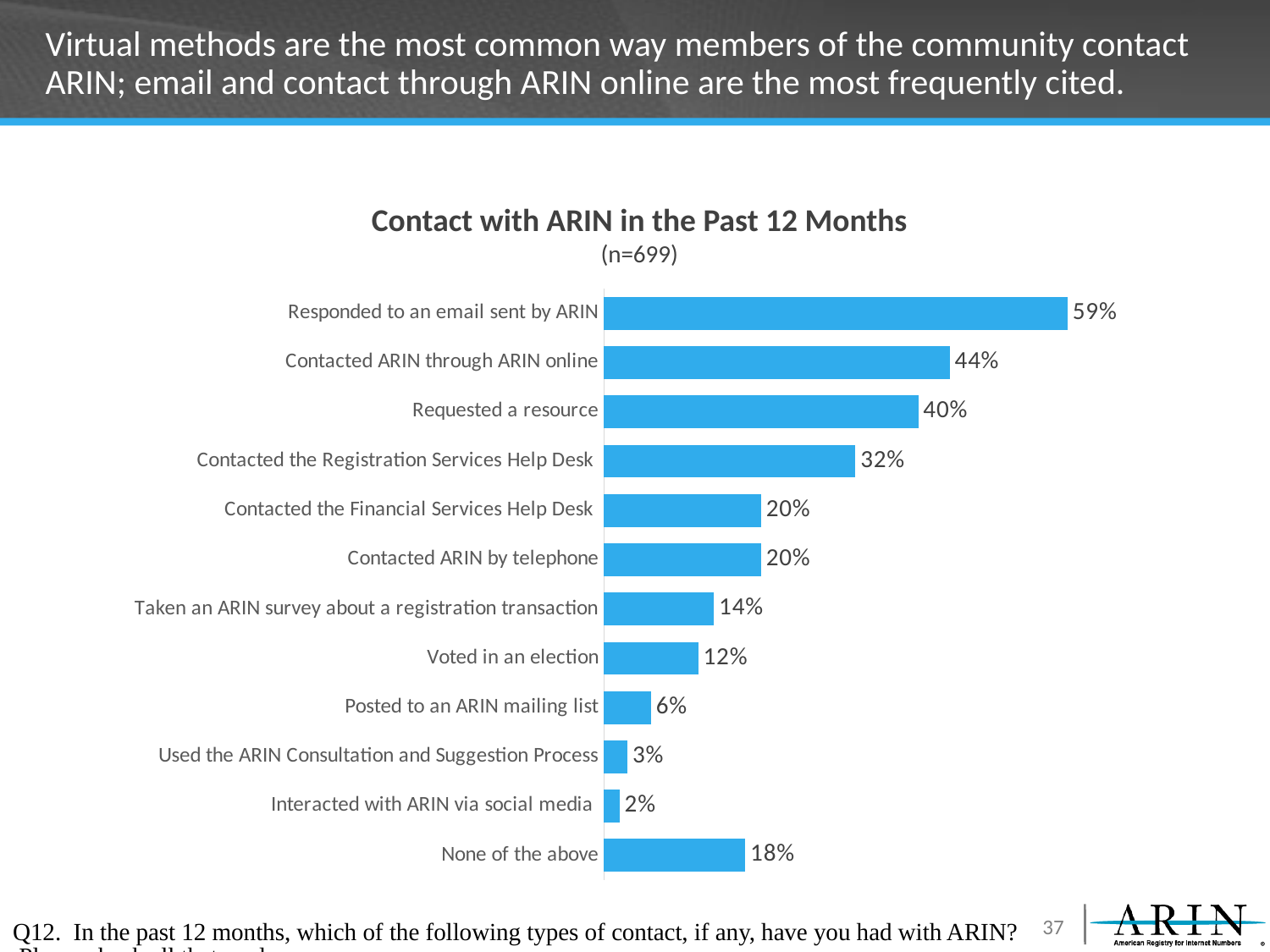
Which is larger: "Posted to an ARIN mailing list" or "Used the ARIN Consultation and Suggestion Process"? Posted to an ARIN mailing list Which category has the lowest value? Interacted with ARIN via social media What is the difference between "Requested a resource" and "Contacted the Registration Services Help Desk"? 8% Which category has the highest value? Responded to an email sent by ARIN What percentage of respondents selected "None of the above"? 18% How many categories are shown in the chart? 12 What is the value for "Voted in an election"? 12% What is the value for "Contacted ARIN through ARIN online"? 44% What percentage of respondents responded to an email sent by ARIN? 59% What is the difference between "Responded to an email sent by ARIN" and "Contacted ARIN through ARIN online"? 15% What kind of chart is shown on the slide? Bar chart What is the sample size (n) shown under the chart title? 699